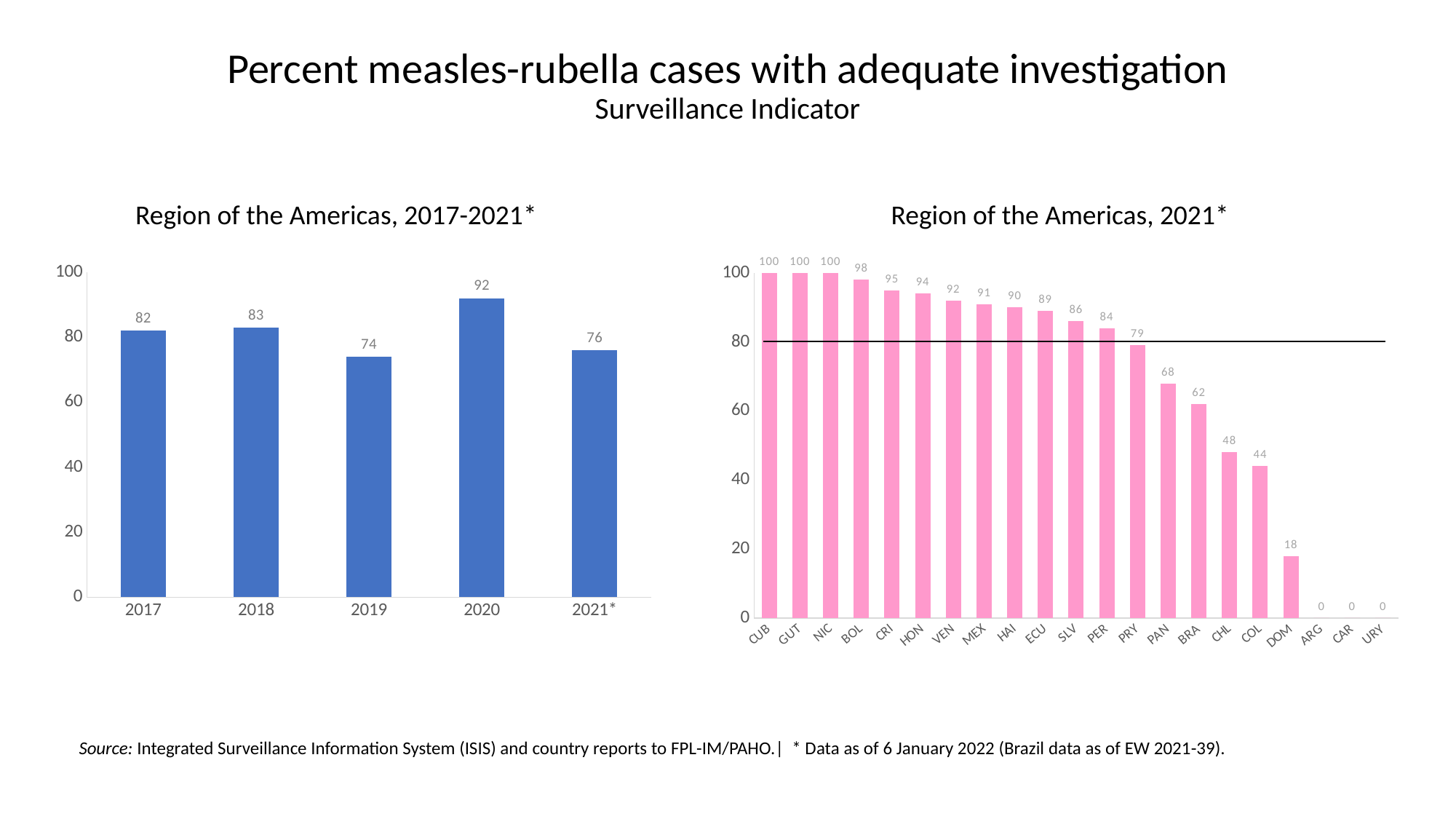
In the 'Region of the Americas, 2021*' chart, how many countries are shown on the x axis? 21 In the 'Region of the Americas, 2021*' chart, at what value is the horizontal reference line drawn? 80 In the 'Region of the Americas, 2017-2021*' chart, which year has the lowest value? 2019 In the 'Region of the Americas, 2017-2021*' chart, is the value for 2018 greater or less than 80? greater In the 'Region of the Americas, 2021*' chart, what is the value for PRY? 79 In the 'Region of the Americas, 2017-2021*' chart, what is the value for 2020? 92 In the 'Region of the Americas, 2017-2021*' chart, how many years are shown on the x axis? 5 In the 'Region of the Americas, 2021*' chart, what is the difference between the values for CHL and COL? 4 In the 'Region of the Americas, 2021*' chart, what is the value for DOM? 18 In the 'Region of the Americas, 2017-2021*' chart, what is the difference between the values for 2020 and 2021*? 16 What kind of chart is the 'Region of the Americas, 2021*' chart? Bar chart In the 'Region of the Americas, 2021*' chart, which is larger, the value for PAN or the value for BRA? PAN